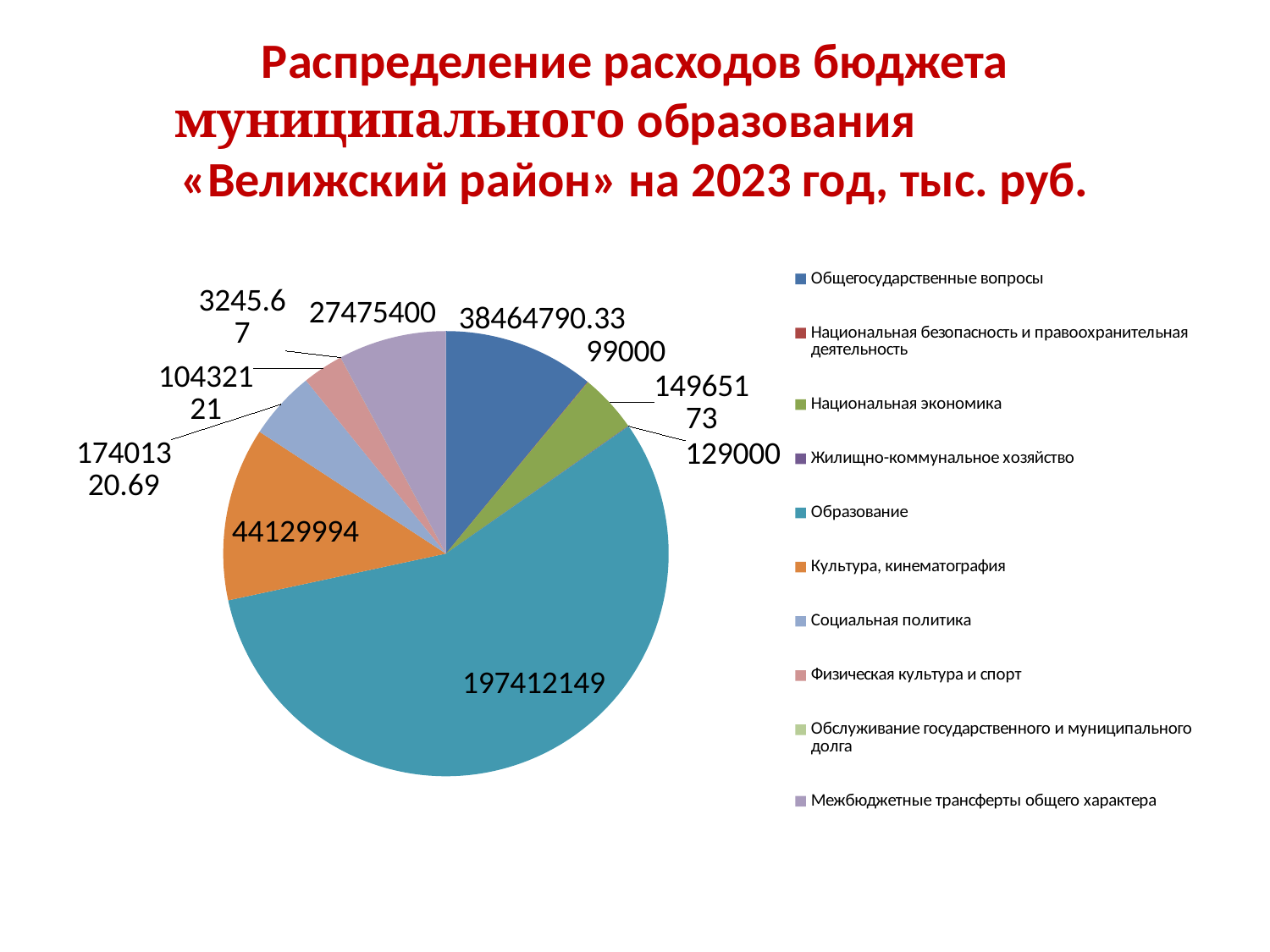
What is the value shown for Общегосударственные вопросы? 38464790.33 How many categories does the legend of the pie chart list? 10 What is the difference between the values for Культура, кинематография and Общегосударственные вопросы? 5665203.67 What kind of chart is shown on the slide? pie chart Which category has the largest slice of the pie chart? Образование What is the value shown for Культура, кинематография? 44129994 What is the value shown for Образование? 197412149 What is the difference between the values for Образование and Культура, кинематография? 153282155 Which is larger, the value for Образование or the value for Культура, кинематография? Образование For which year does the chart title say the budget expenditure distribution is shown? 2023 What is the value shown for Межбюджетные трансферты общего характера? 27475400 Which is larger, the value for Культура, кинематография or the value for Общегосударственные вопросы? Культура, кинематография